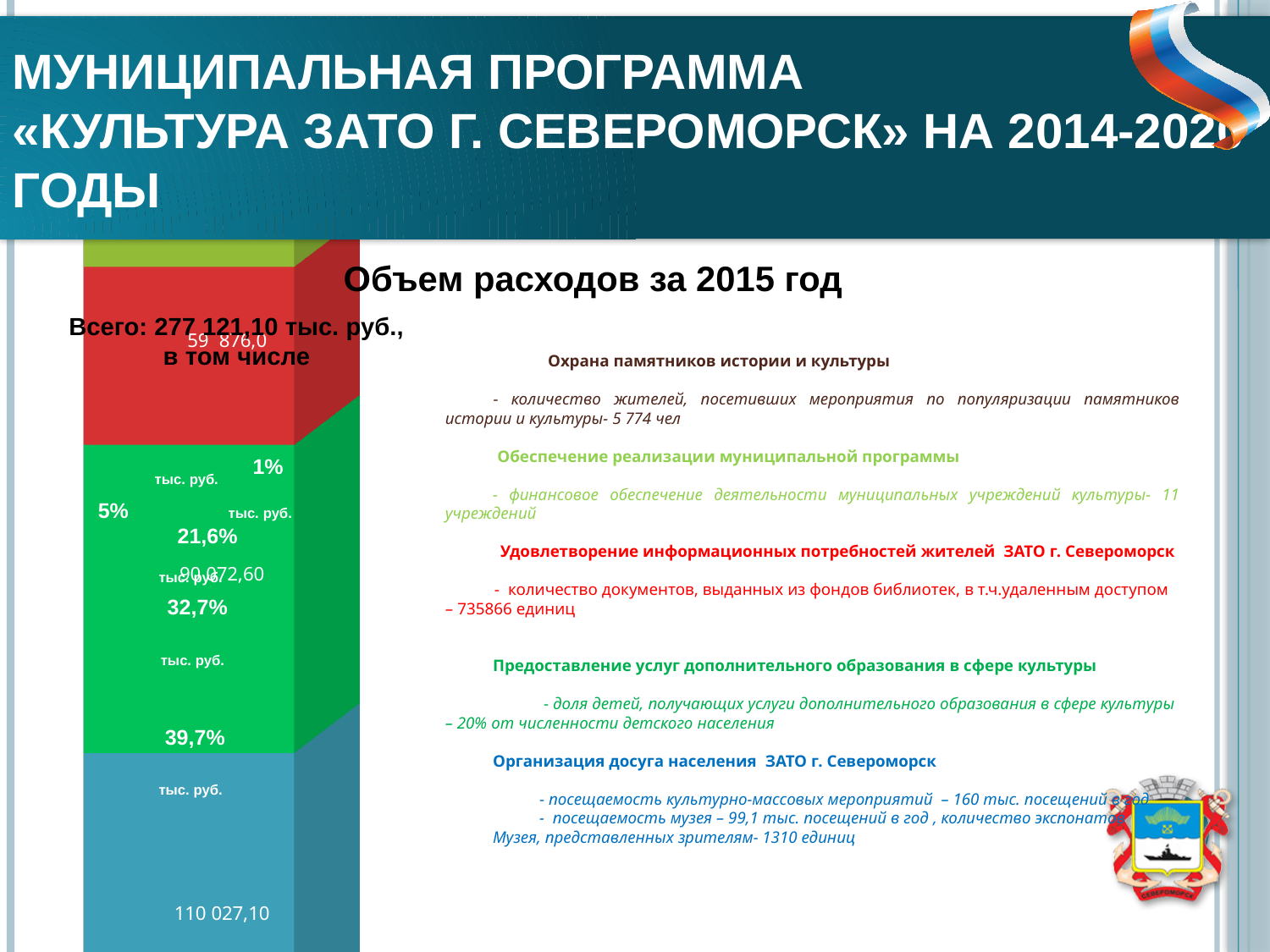
What kind of chart is shown on the slide? Stacked bar chart What value is printed on the green segment of the bar? 90 672,60 What percentage share is shown for the red segment? 21,6% What total amount is stated for the stacked bar (Всего)? 277 121,10 тыс. руб. What is the title of the chart on the slide? Объем расходов за 2015 год What value is printed on the blue (bottom) segment of the bar? 110 027,10 Which segment of the bar has the largest printed value? The blue (bottom) segment, 110 027,10 What is the difference between the blue segment value (110 027,10) and the green segment value (90 672,60)? 19 354,50 What percentage share is shown for the green segment? 32,7% What value is printed on the red segment of the bar? 59 876,0 What is the smallest percentage label shown on the chart? 1% What percentage share is shown for the blue (bottom) segment? 39,7%